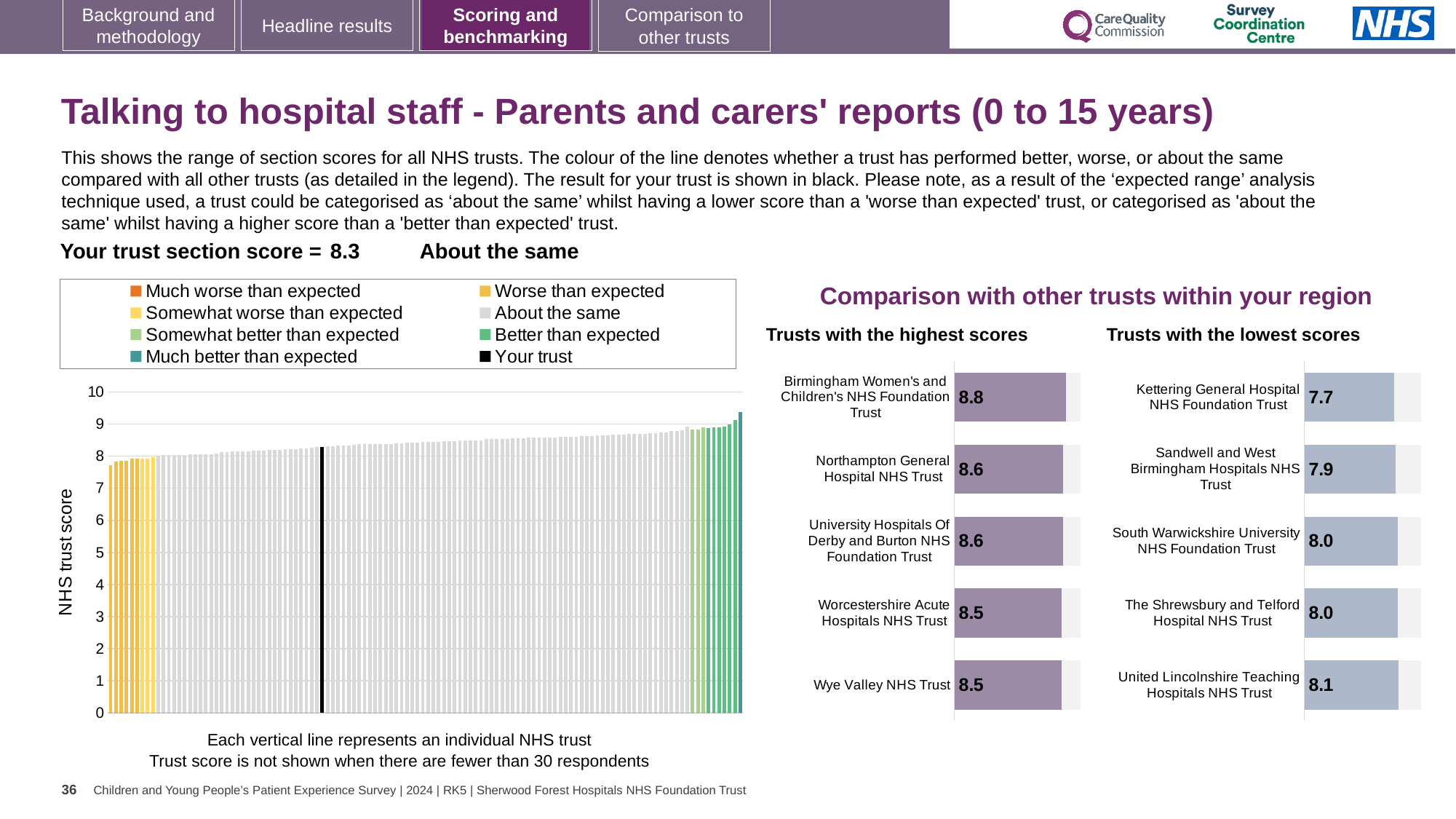
In the 'Trusts with the highest scores' chart, what is the difference between the scores of Birmingham Women's and Children's NHS Foundation Trust and Wye Valley NHS Trust? 0.3 In the 'Trusts with the lowest scores' chart, which trust has the lowest score? Kettering General Hospital NHS Foundation Trust How many trusts are shown in the 'Trusts with the highest scores' chart? 5 What kind of chart is the main 'NHS trust score' chart on the left? Bar chart How many entries does the legend of the main 'NHS trust score' chart list? 8 In the 'Trusts with the highest scores' chart, which trust has the highest score? Birmingham Women's and Children's NHS Foundation Trust In the main 'NHS trust score' chart, do the values rise or fall from left to right? Rise In the 'Trusts with the highest scores' chart, what is the score for Birmingham Women's and Children's NHS Foundation Trust? 8.8 In the 'Trusts with the lowest scores' chart, what is the score for Kettering General Hospital NHS Foundation Trust? 7.7 What is the section score for your trust shown on the slide? 8.3 In the 'Trusts with the highest scores' chart, which has the larger score: Northampton General Hospital NHS Trust or Worcestershire Acute Hospitals NHS Trust? Northampton General Hospital NHS Trust In the 'Trusts with the lowest scores' chart, what is the difference between the scores of United Lincolnshire Teaching Hospitals NHS Trust and Kettering General Hospital NHS Foundation Trust? 0.4